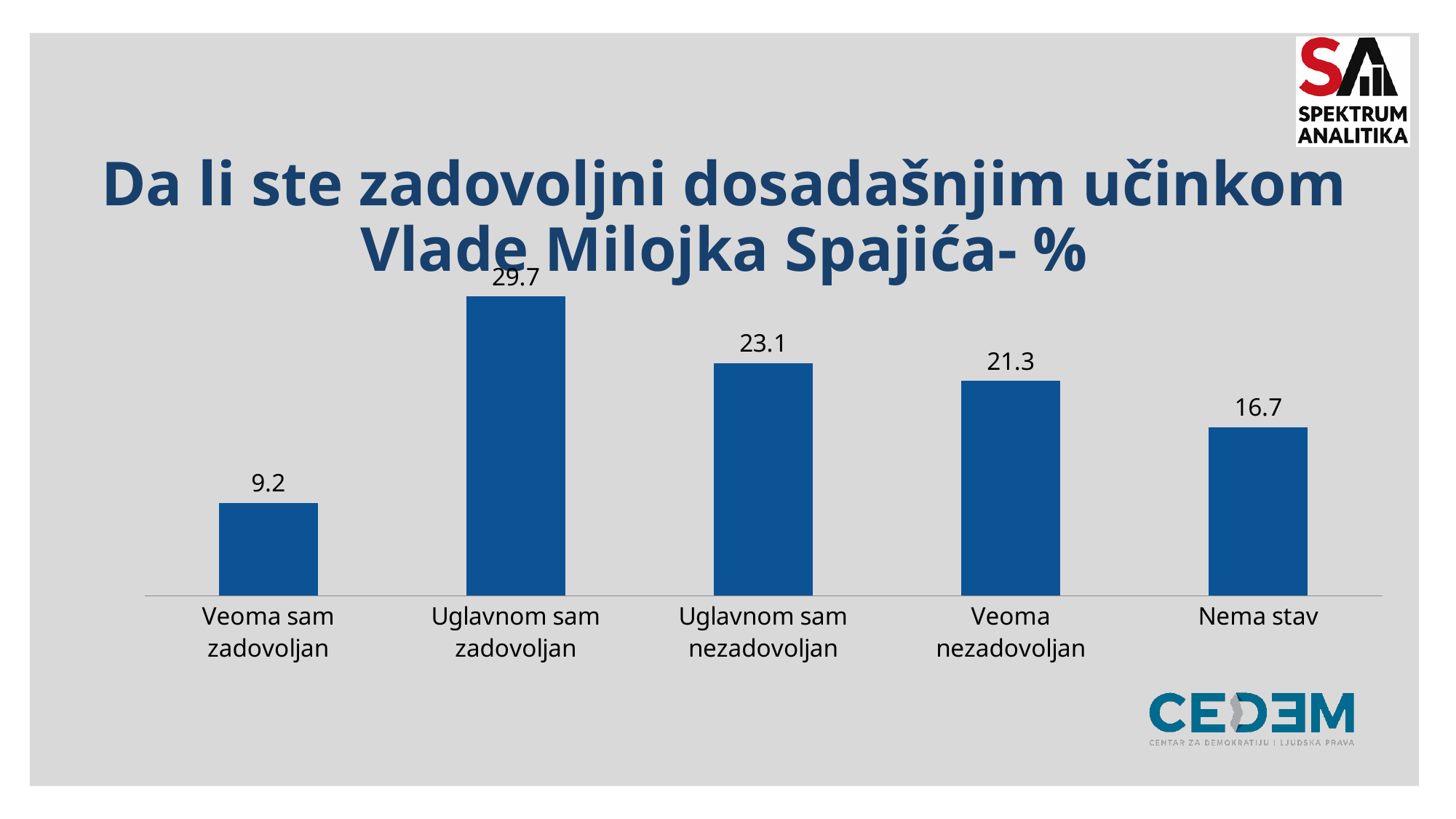
What is the difference between "Veoma nezadovoljan" and "Nema stav"? 4.6 What is the value for "Veoma nezadovoljan"? 21.3 Which is larger, "Uglavnom sam nezadovoljan" or "Veoma nezadovoljan"? Uglavnom sam nezadovoljan Which category has the highest value? Uglavnom sam zadovoljan What kind of chart is shown on the slide? Bar chart Which category has the lowest value? Veoma sam zadovoljan How many categories are shown in the chart? 5 What is the difference between "Uglavnom sam zadovoljan" and "Uglavnom sam nezadovoljan"? 6.6 What is the value for "Nema stav"? 16.7 What is the value for "Uglavnom sam zadovoljan"? 29.7 What is the value for "Veoma sam zadovoljan"? 9.2 What is the title of the chart? Da li ste zadovoljni dosadašnjim učinkom Vlade Milojka Spajića- %